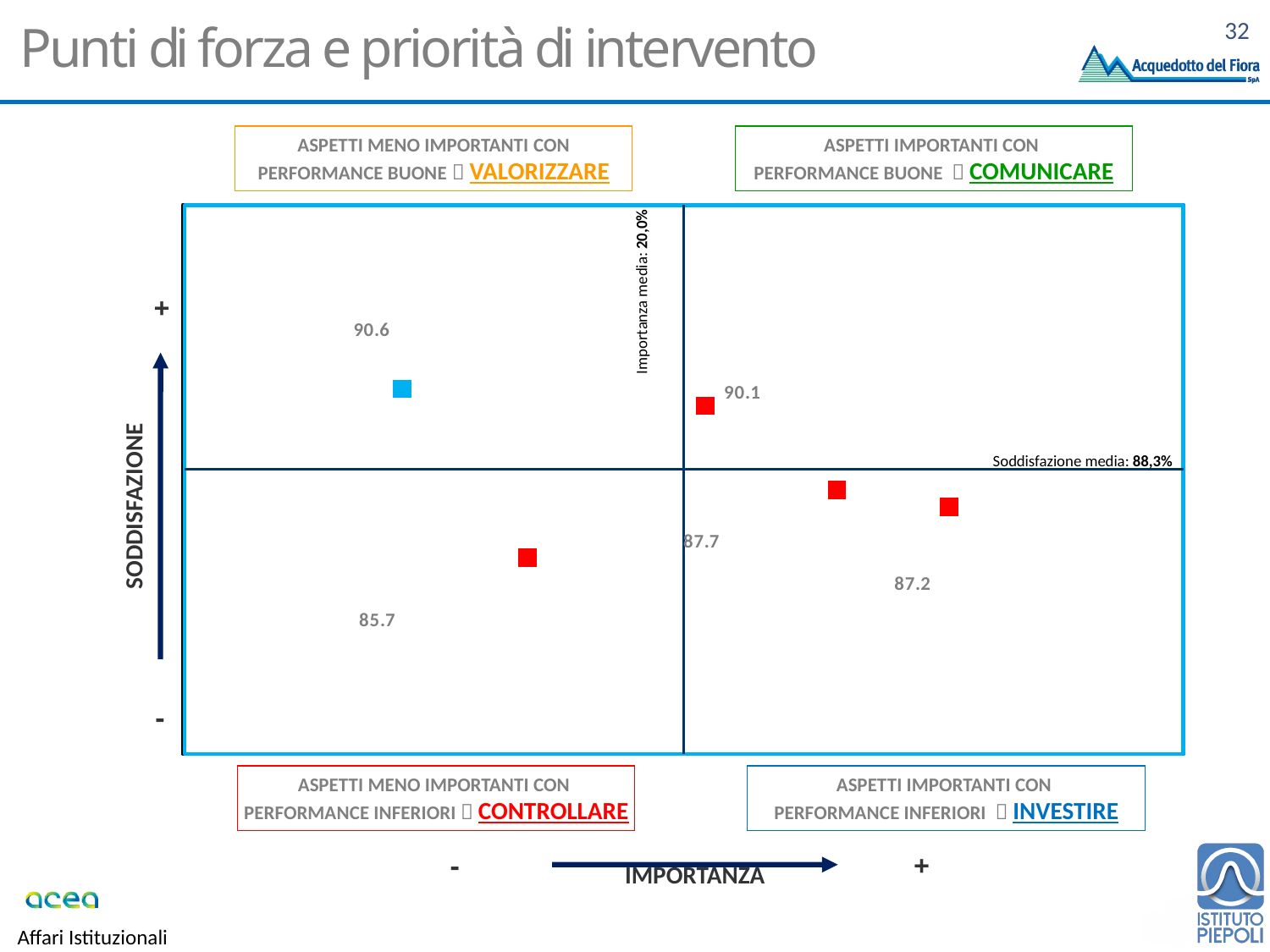
What colour is the marker next to the 90.6 label? light blue What kind of chart is shown on the slide? scatter chart What is the difference between the highest labelled value (90.6) and the lowest labelled value (85.7)? 4.9 What is the average importance (Importanza media) indicated by the vertical reference line? 20,0% What is the lowest value labelled on the chart? 85.7 How many data points are plotted on the chart? 5 What is the highest value labelled on the chart? 90.6 How many points lie above the Soddisfazione media line? 2 What is the average satisfaction (Soddisfazione media) indicated by the horizontal reference line? 88,3% How many points lie to the right of the Importanza media line? 3 Which labelled value is larger, 90.1 or 87.2? 90.1 What is the label of the vertical axis of the chart? SODDISFAZIONE